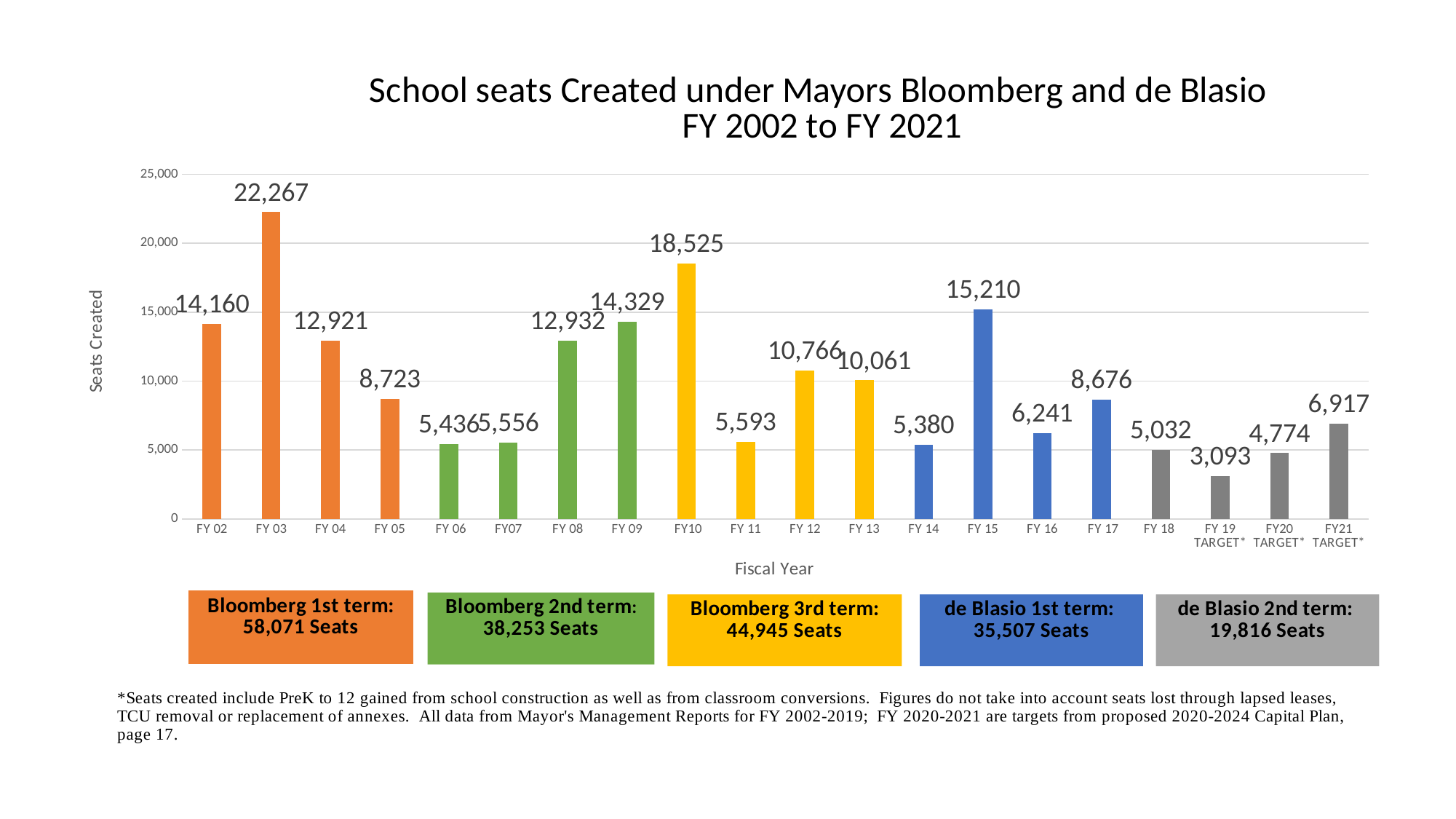
What kind of chart is this? bar chart Which is larger, the value for FY 09 or FY 08? FY 09 What is the difference between the FY 03 and FY10 values? 3,742 What is the difference between the FY 15 and FY 14 values? 9,830 From FY 03 to FY 06, do the values rise or fall? fall What is the value shown for FY10? 18,525 What is the FY21 TARGET* value? 6,917 How many fiscal year categories are shown on the x axis? 20 Which fiscal year has the highest number of seats created? FY 03 Is the value for FY 05 greater or less than 10,000? less Which category has the lowest value on the chart? FY 19 TARGET* How many seats were created in FY 03? 22,267